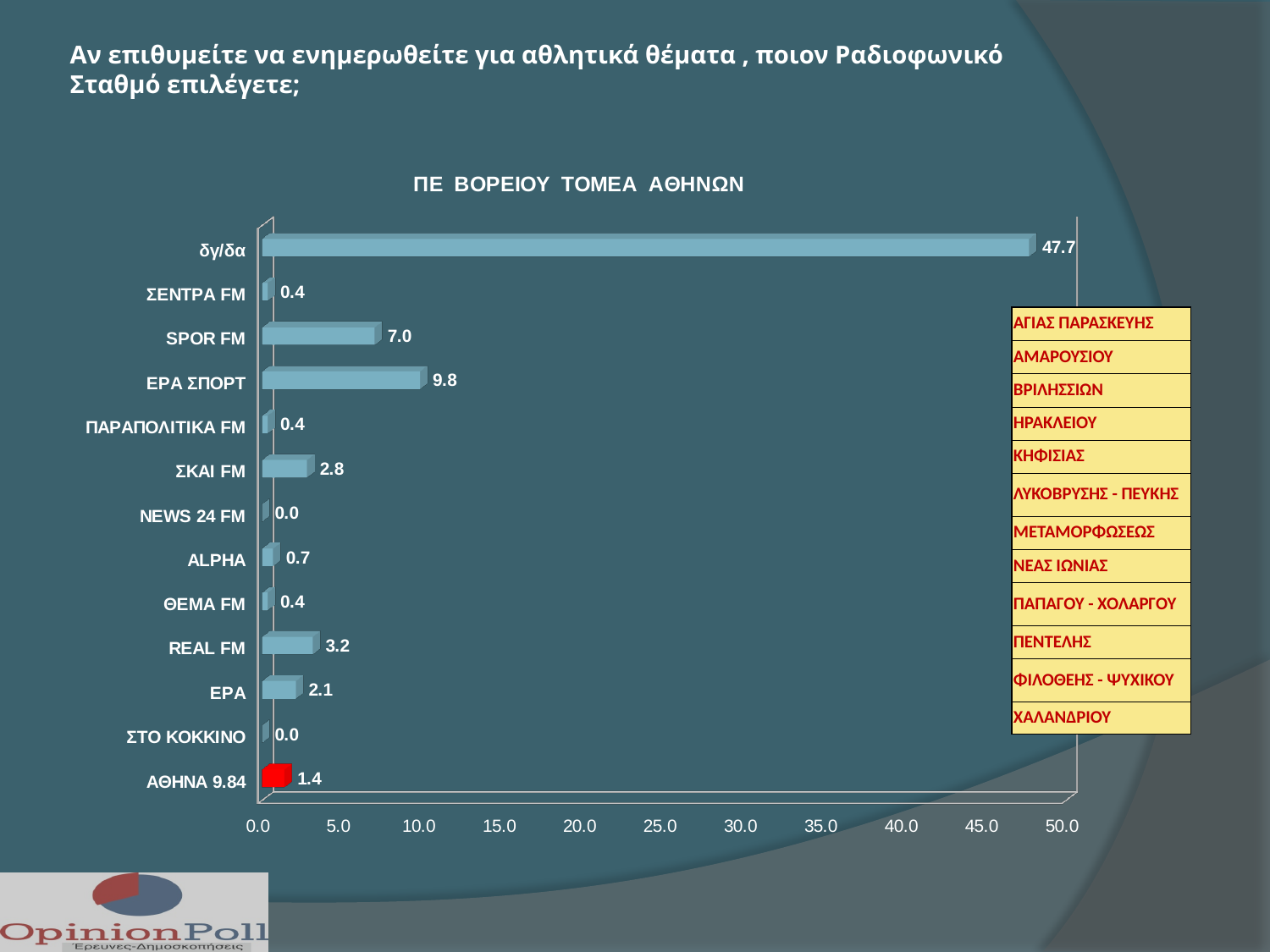
What is the difference between the values for ΕΡΑ ΣΠΟΡΤ and SPOR FM? 2.8 How many categories have a value of 0.0? 2 What kind of chart is shown on the slide? bar chart What is the value for ΕΡΑ ΣΠΟΡΤ? 9.8 What is the value for SPOR FM? 7.0 What is the title of the chart? ΠΕ ΒΟΡΕΙΟΥ ΤΟΜΕΑ ΑΘΗΝΩΝ What is the value for ΑΘΗΝΑ 9.84? 1.4 How many categories are shown on the chart? 13 Which is larger, the value for REAL FM or the value for ΣΚΑΙ FM? REAL FM Which category has the highest value? δγ/δα What is the value for δγ/δα? 47.7 Is the value for δγ/δα greater or less than 45.0? greater